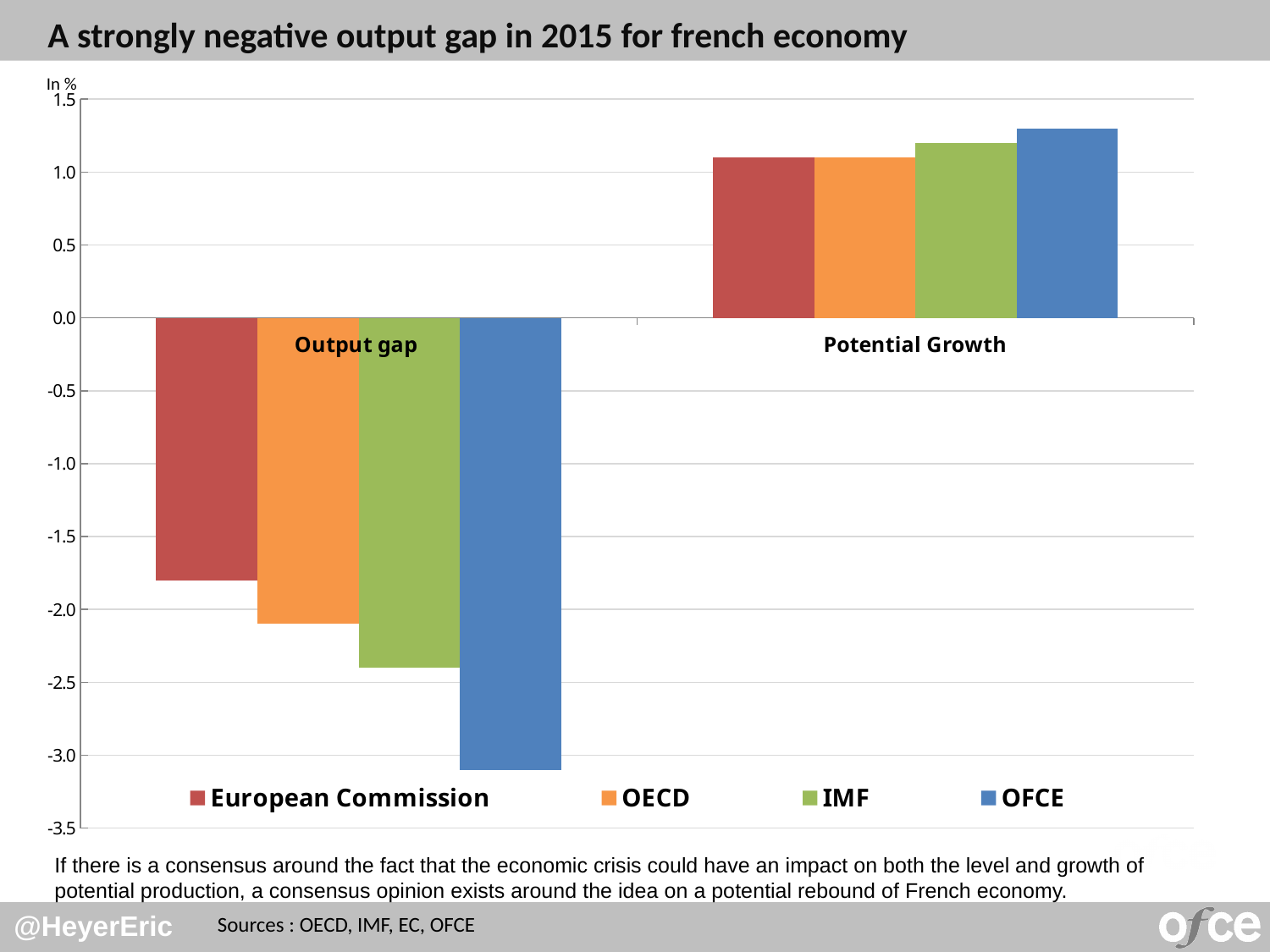
What kind of chart is shown on the slide? bar chart How many categories are shown on the x axis? 2 What unit is indicated on the vertical axis of the chart? In % How many series does the legend list? 4 For Output gap, which is more negative: the OECD value or the IMF value? IMF Is the IMF value for Output gap greater or less than -2.0? less Is the European Commission value for Output gap greater or less than -2.0? greater Which institution shows the highest value for Potential Growth? OFCE Which institution shows the lowest (most negative) value for Output gap? OFCE Which institution shows the highest (least negative) value for Output gap? European Commission Is the OFCE value for Potential Growth greater or less than 1.0? greater